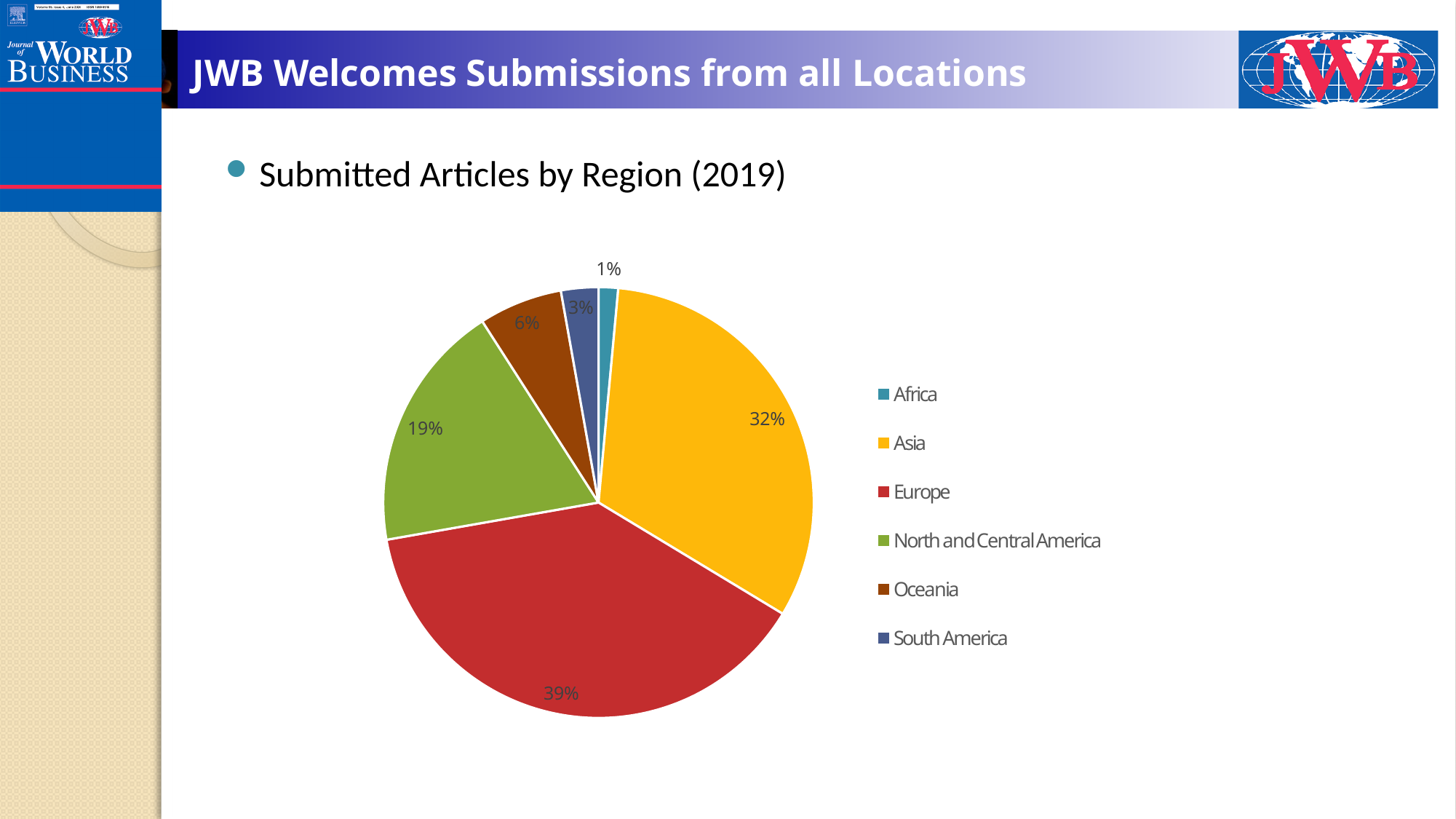
What is the difference in percentage points between Europe's and Asia's shares? 7 What share of submitted articles came from North and Central America? 19% What share of submitted articles came from Europe? 39% What share of submitted articles came from South America? 3% Which region has the largest share of submitted articles? Europe Which region has the smallest share of submitted articles? Africa Which has a larger share, North and Central America or Oceania? North and Central America How many regions are shown in the pie chart? 6 What kind of chart is shown on the slide? Pie chart